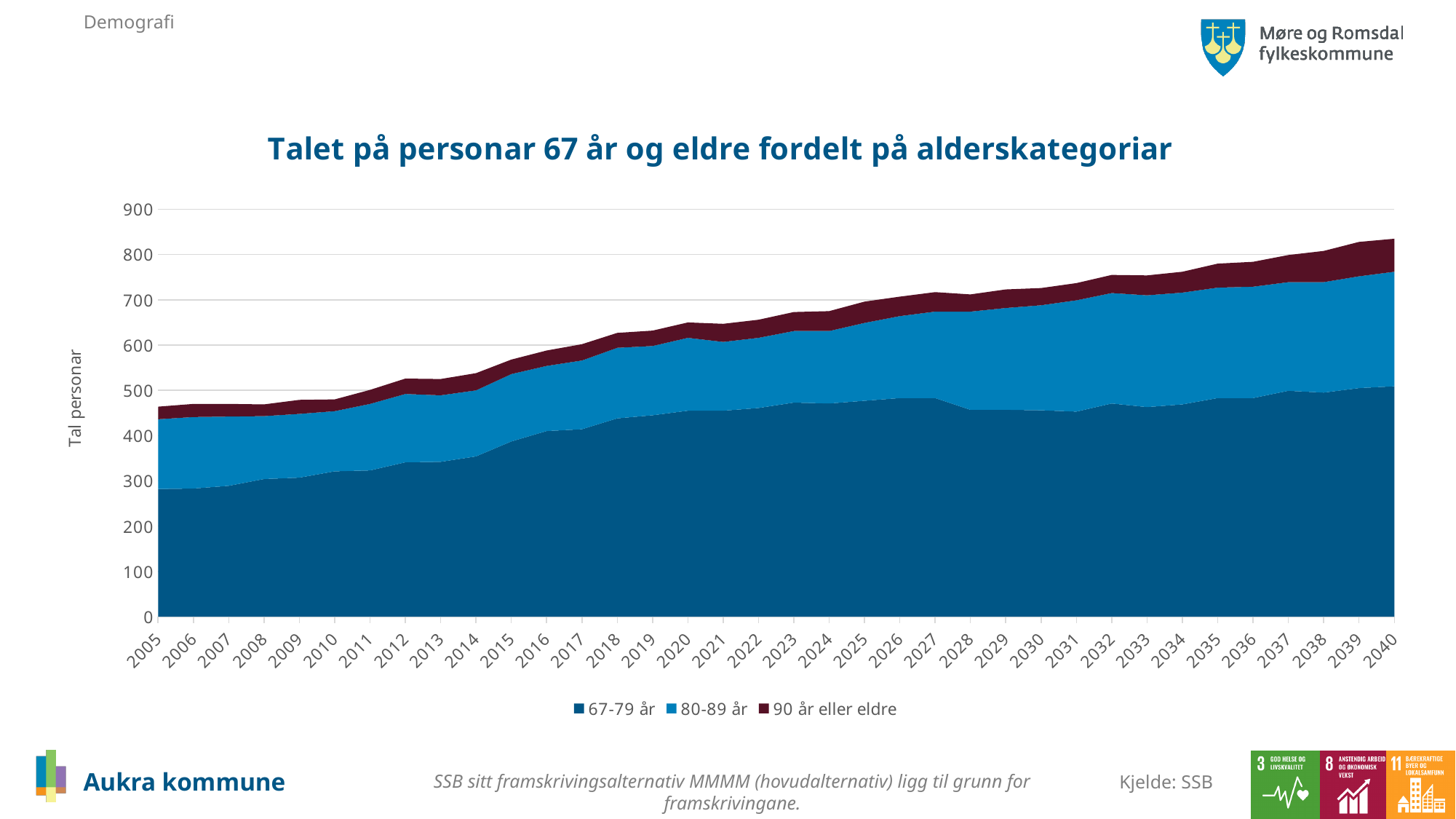
Which is larger in 2040: the value for 67-79 år or the value for 90 år eller eldre? 67-79 år What kind of chart is shown on the slide? Stacked area chart Is the total stacked value for 2040 greater or less than 800? greater How many years are shown along the x axis? 36 Is the value for 67-79 år in 2040 greater or less than 400? greater Does the total number of persons 67 years and older rise or fall from 2005 to 2040? Rise What is the label on the y axis? Tal personar How many series does the legend list? 3 What is the title of the chart? Talet på personar 67 år og eldre fordelt på alderskategoriar Is the total stacked value for 2005 greater or less than 500? less